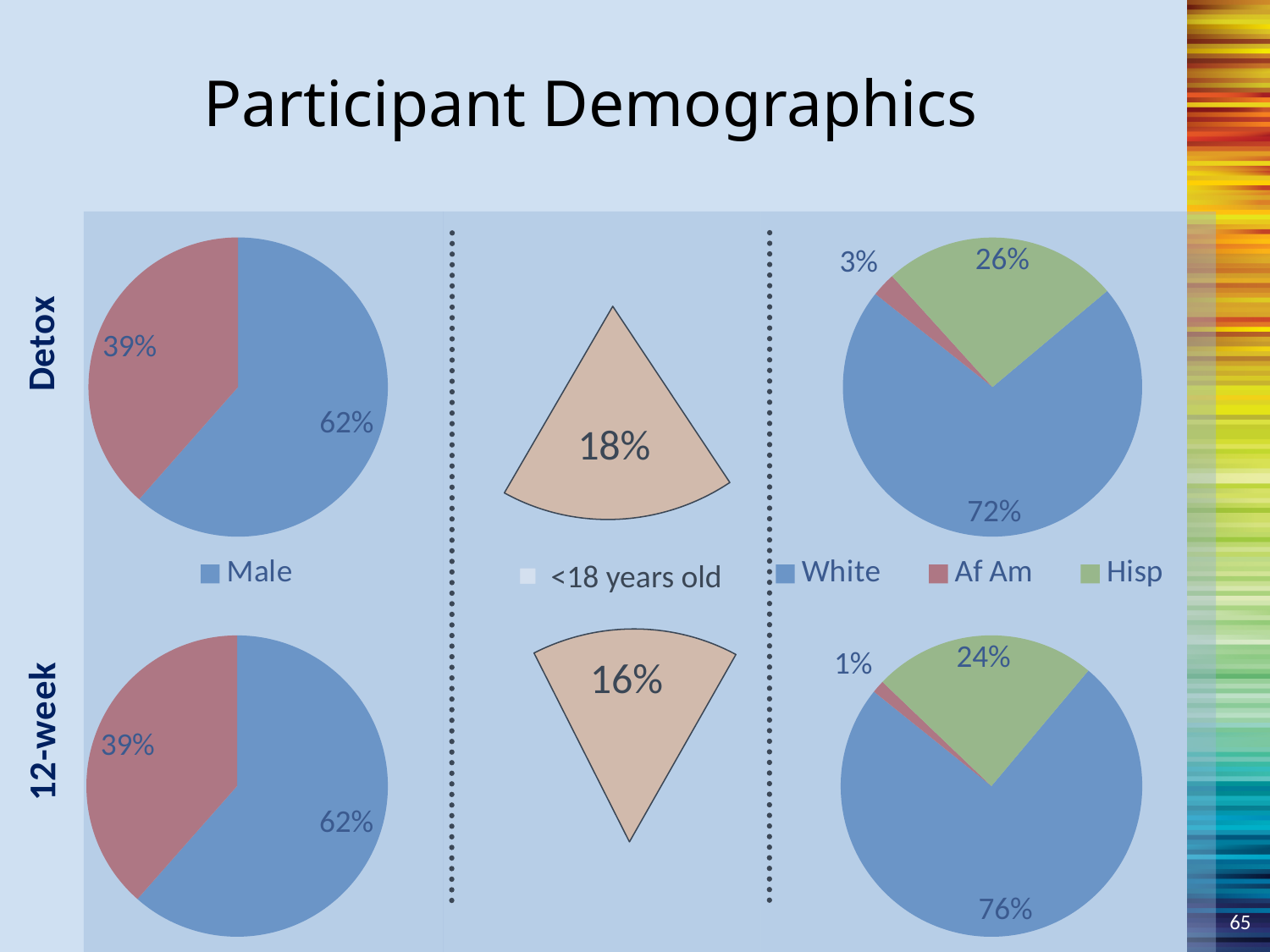
In the 12-week race pie chart, which category has the smallest share? Af Am In the Detox age chart, what percentage of participants are <18 years old? 18% In the 12-week age chart, what percentage of participants are <18 years old? 16% In the Detox gender pie chart, what percentage is Male? 62% In the Detox race pie chart, what is the difference between the White and Hisp percentages? 46% In the Detox race pie chart, what percentage is White? 72% In the 12-week race pie chart, what percentage is Af Am? 1% In the 12-week race pie chart, what percentage is White? 76% How many categories does the legend of the race pie charts list? 3 In the Detox race pie chart, what percentage is Hisp? 26% In the Detox race pie chart, which category has the largest share? White Is the Hisp share larger in the Detox race pie chart or the 12-week race pie chart? Detox